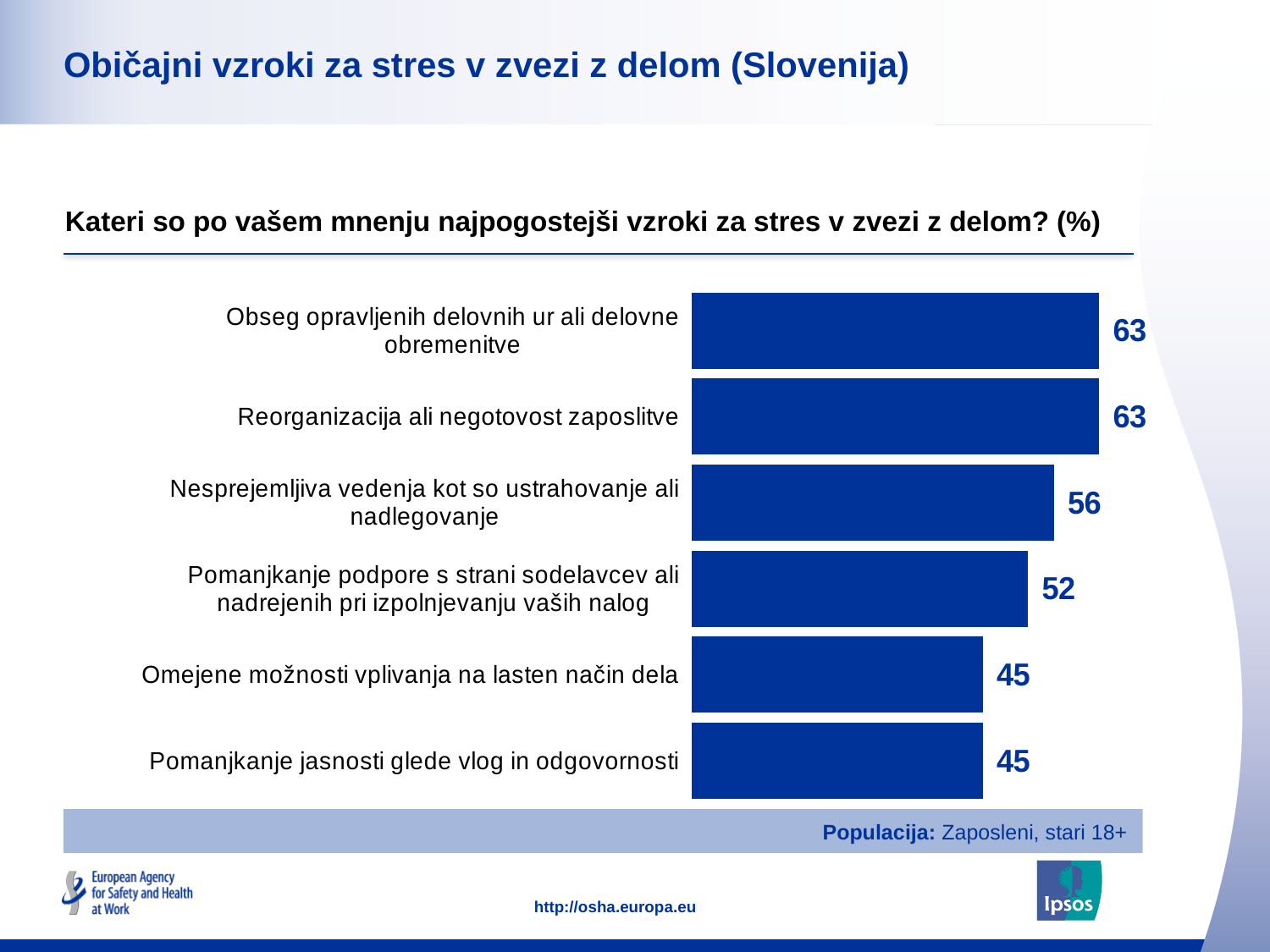
What is the lowest value shown in the chart? 45 What is the highest value shown in the chart? 63 Which has a larger value: "Reorganizacija ali negotovost zaposlitve" or "Omejene možnosti vplivanja na lasten način dela"? Reorganizacija ali negotovost zaposlitve What value is shown for "Reorganizacija ali negotovost zaposlitve"? 63 What value is shown for "Nesprejemljiva vedenja kot so ustrahovanje ali nadlegovanje"? 56 What is the title of the chart? Kateri so po vašem mnenju najpogostejši vzroki za stres v zvezi z delom? (%) How many categories are shown in the chart? 6 What is the difference between the value for "Nesprejemljiva vedenja kot so ustrahovanje ali nadlegovanje" and the value for "Pomanjkanje podpore s strani sodelavcev ali nadrejenih pri izpolnjevanju vaših nalog"? 4 What is the difference between the value for "Obseg opravljenih delovnih ur ali delovne obremenitve" and the value for "Pomanjkanje jasnosti glede vlog in odgovornosti"? 18 What value is shown for "Pomanjkanje podpore s strani sodelavcev ali nadrejenih pri izpolnjevanju vaših nalog"? 52 What kind of chart is shown on the slide? Bar chart What value is shown for "Omejene možnosti vplivanja na lasten način dela"? 45